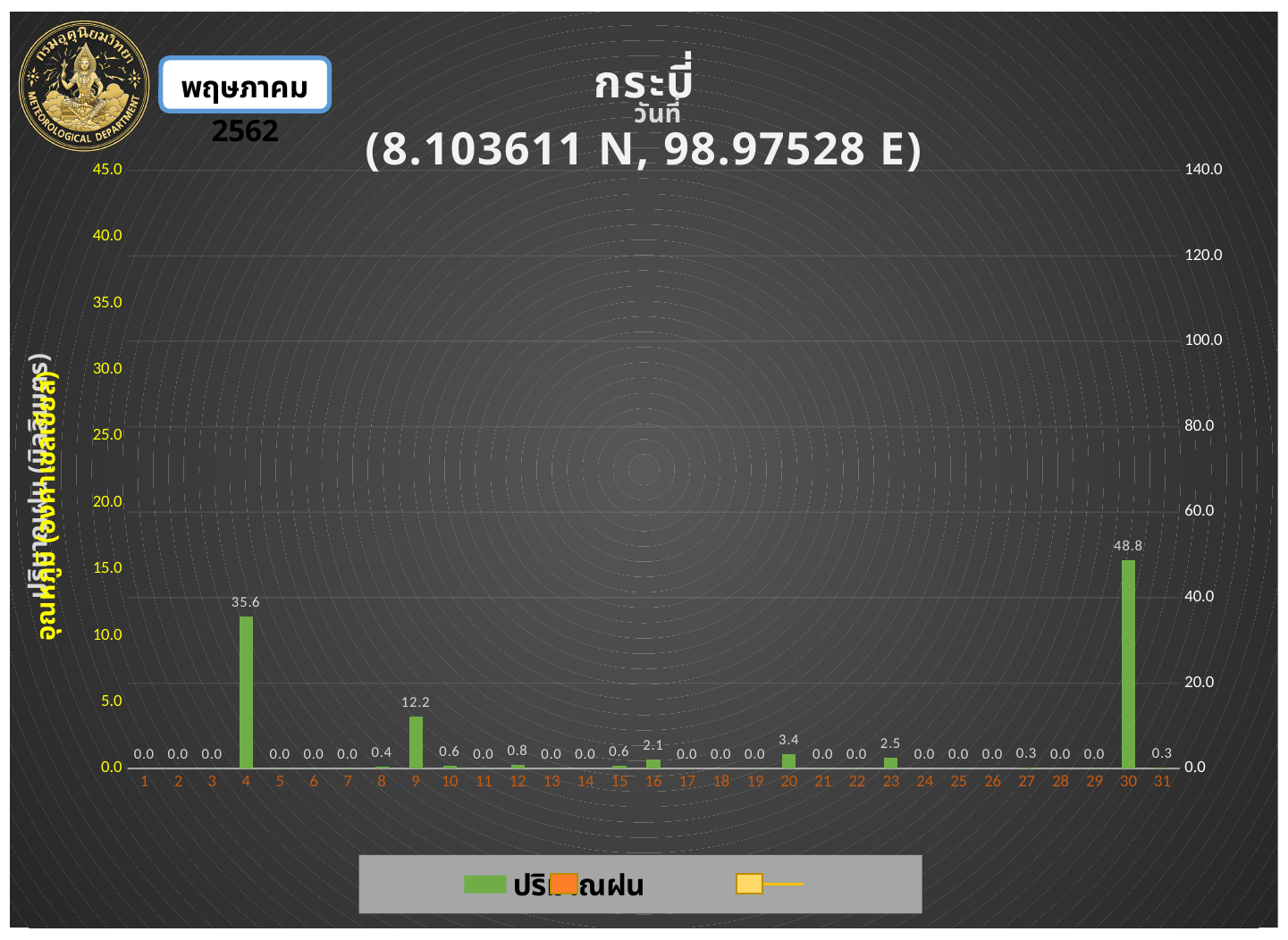
What is the rainfall value shown for day 9? 12.2 What is the difference between the rainfall values for day 30 and day 4? 13.2 What is the difference between the rainfall values for day 9 and day 20? 8.8 What is the rainfall value shown for day 23? 2.5 What is the rainfall value shown for day 30? 48.8 What is the rainfall value shown for day 4? 35.6 What is the rainfall value shown for day 20? 3.4 Which day has the larger rainfall value, day 4 or day 9? 4 Which day has the highest rainfall value? 30 What kind of chart is used to show the rainfall values? bar chart How many days are shown on the x axis? 31 Is the rainfall value for day 30 greater or less than 40.0 on the right axis? greater